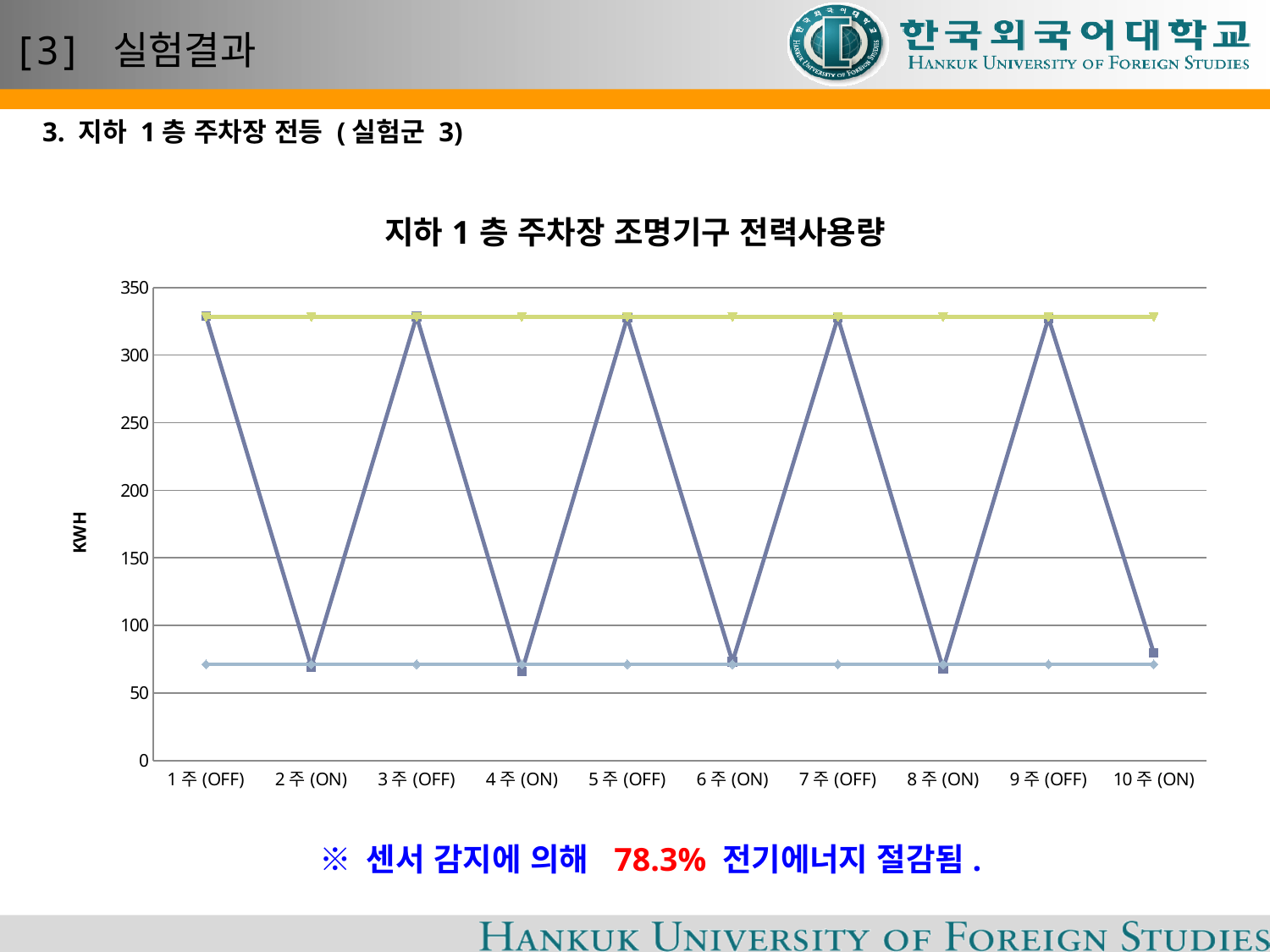
How many week categories are shown on the x axis of the chart? 10 Is the flat light blue line above or below 100 on the y axis? below Is the value of the zigzag line at 10 주 (ON) greater or less than 150? less What is the title of the chart? 지하 1 층 주차장 조명기구 전력사용량 What kind of chart is shown on the slide? line chart Is the value of the zigzag line at 1 주 (OFF) greater or less than 300? greater On the zigzag line, which is larger: the value at 1 주 (OFF) or the value at 2 주 (ON)? 1 주 (OFF) How many lines are plotted on the chart? 3 Does the zigzag line rise steadily, fall steadily, or alternate up and down across the weeks? alternate up and down What is the label on the y axis of the chart? KWH